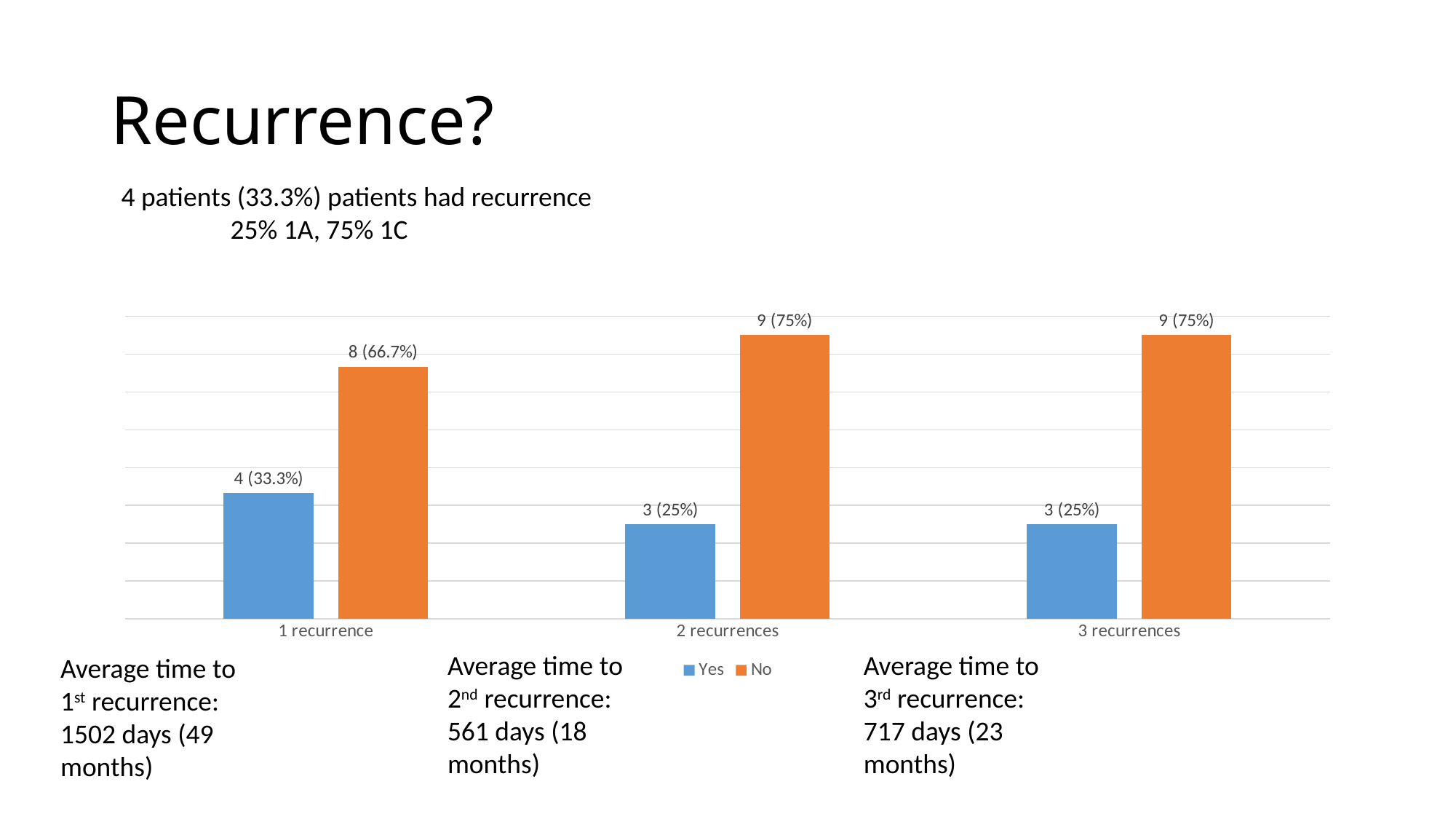
How many categories are shown on the x axis? 3 Which category has the highest Yes value? 1 recurrence What is the data label for the Yes bar at 3 recurrences? 3 (25%) What is the data label for the No bar at 2 recurrences? 9 (75%) Which colour represents the No series in the legend? Orange At 1 recurrence, which is larger, the Yes bar or the No bar? No What is the difference in patient count between the No and Yes bars at 2 recurrences? 6 Which category has the lowest No value? 1 recurrence What is the data label for the No bar at 1 recurrence? 8 (66.7%) What is the data label for the Yes bar at 1 recurrence? 4 (33.3%) What kind of chart is shown on the slide? Bar chart How many series does the legend list? 2